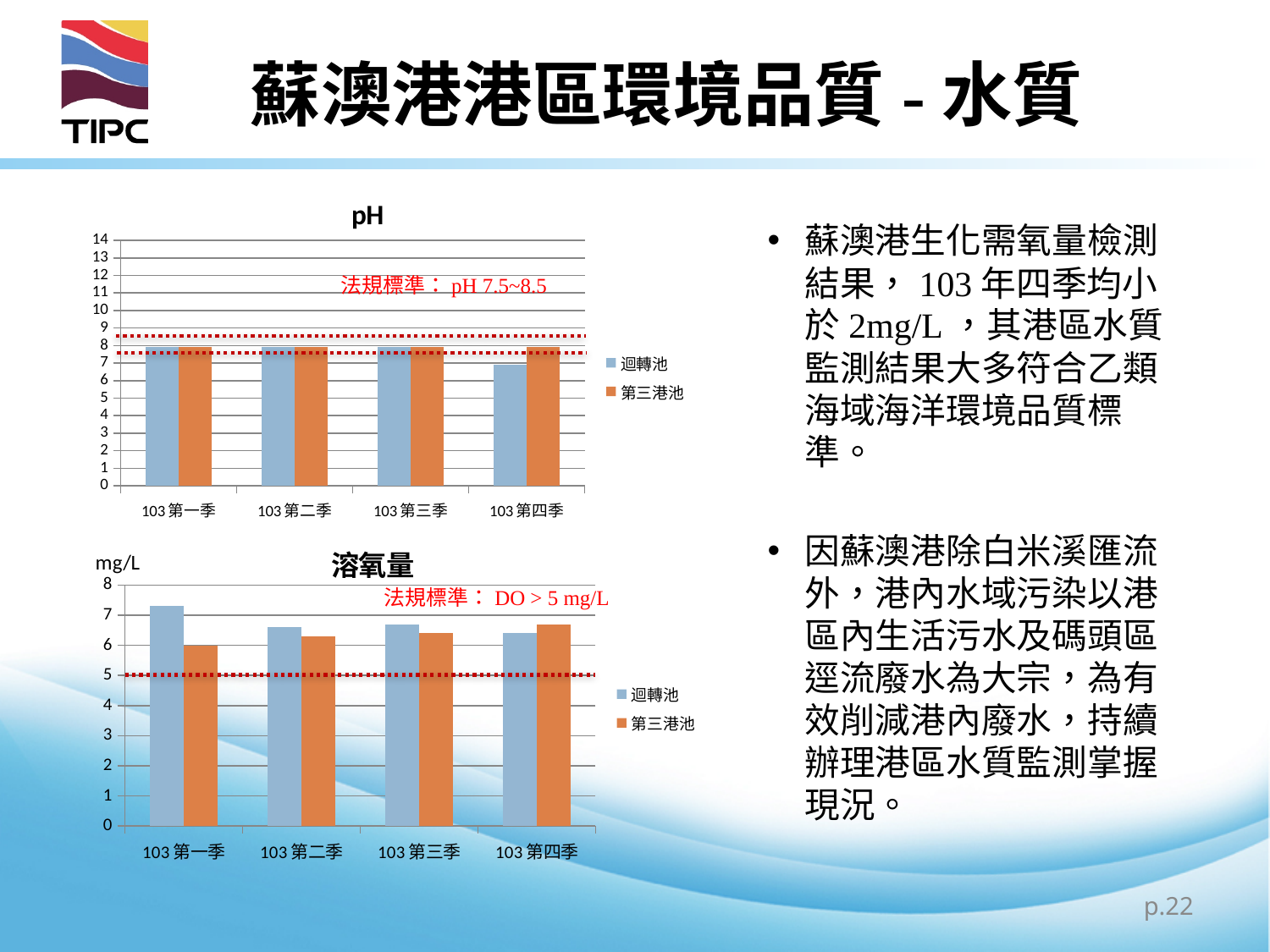
How many categories are shown on the x axis of the pH chart? 4 In the pH chart, is the value for 迴轉池 in 103 第四季 greater or less than 6? greater In the 溶氧量 chart, is the value for 迴轉池 in 103 第一季 greater or less than 7? greater In the 溶氧量 chart, which is larger in 103 第一季, 迴轉池 or 第三港池? 迴轉池 In the 溶氧量 chart, which category has the lowest value for 第三港池? 103 第一季 What regulatory standard is written on the 溶氧量 chart? DO > 5 mg/L What kind of chart is the pH chart? bar chart In the pH chart, which category has the lowest value for 迴轉池? 103 第四季 In the 溶氧量 chart, which category has the highest value for 迴轉池? 103 第一季 In the pH chart, is the value for 第三港池 in 103 第一季 greater or less than 7? greater In the 溶氧量 chart, do the values for 第三港池 rise or fall from 103 第一季 to 103 第四季? rise How many series does the legend of the 溶氧量 chart list? 2